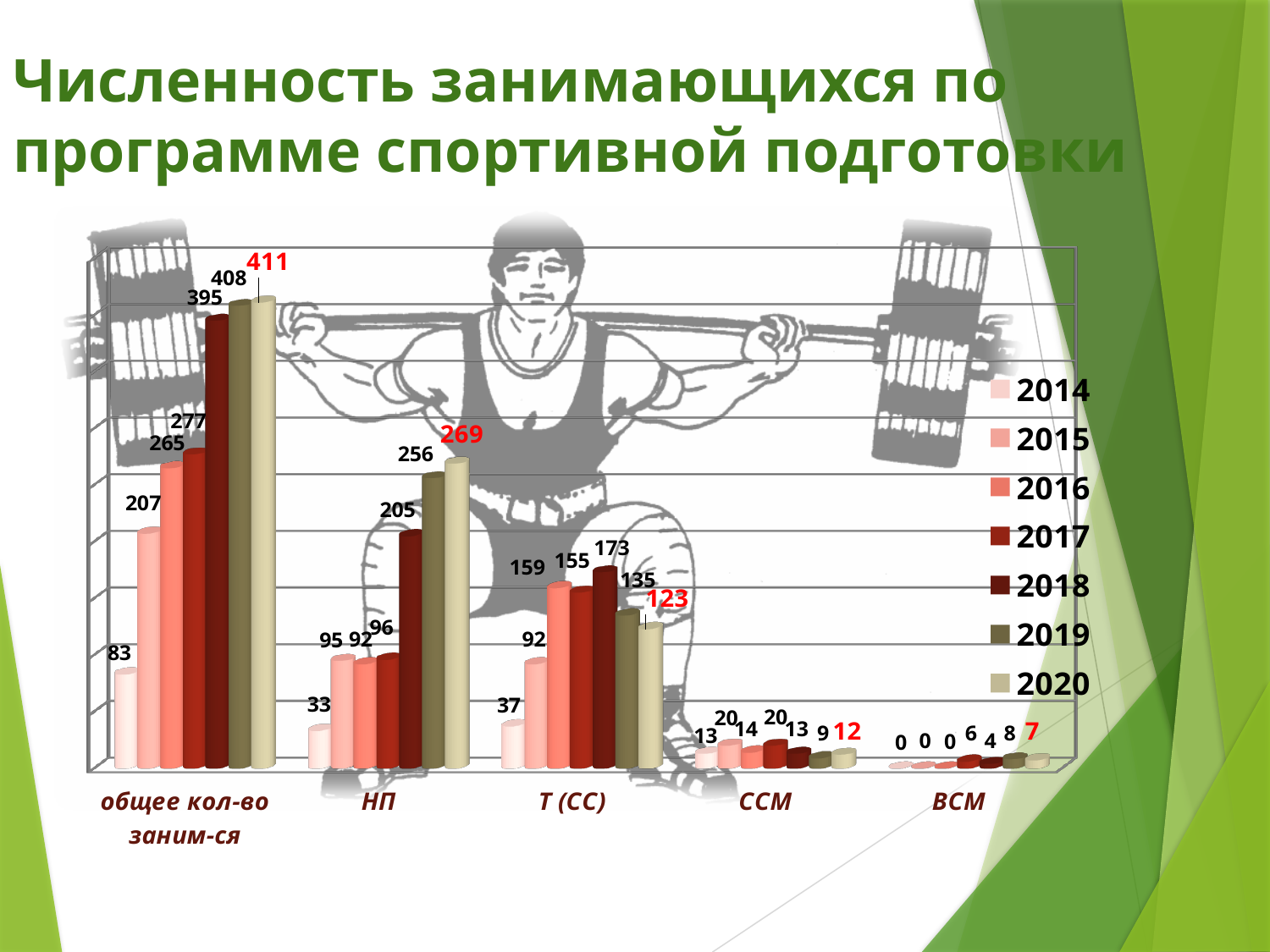
What is the value for 2020 in the "общее кол-во заним-ся" category? 411 What is the value for 2018 in the "Т (СС)" category? 173 What is the value for 2019 in the "ВСМ" category? 8 What is the value for 2014 in the "НП" category? 33 Which is larger in the "Т (СС)" category: the value for 2016 or the value for 2020? 2016 What is the difference between the 2020 and 2014 values in the "общее кол-во заним-ся" category? 328 Which year has the highest value in the "НП" category? 2020 How many series does the legend list? 7 What kind of chart is shown on the slide? bar chart How many categories are shown on the x axis? 5 Which year has the lowest value in the "ССМ" category? 2019 Do the values in the "общее кол-во заним-ся" category rise or fall from 2014 to 2020? rise